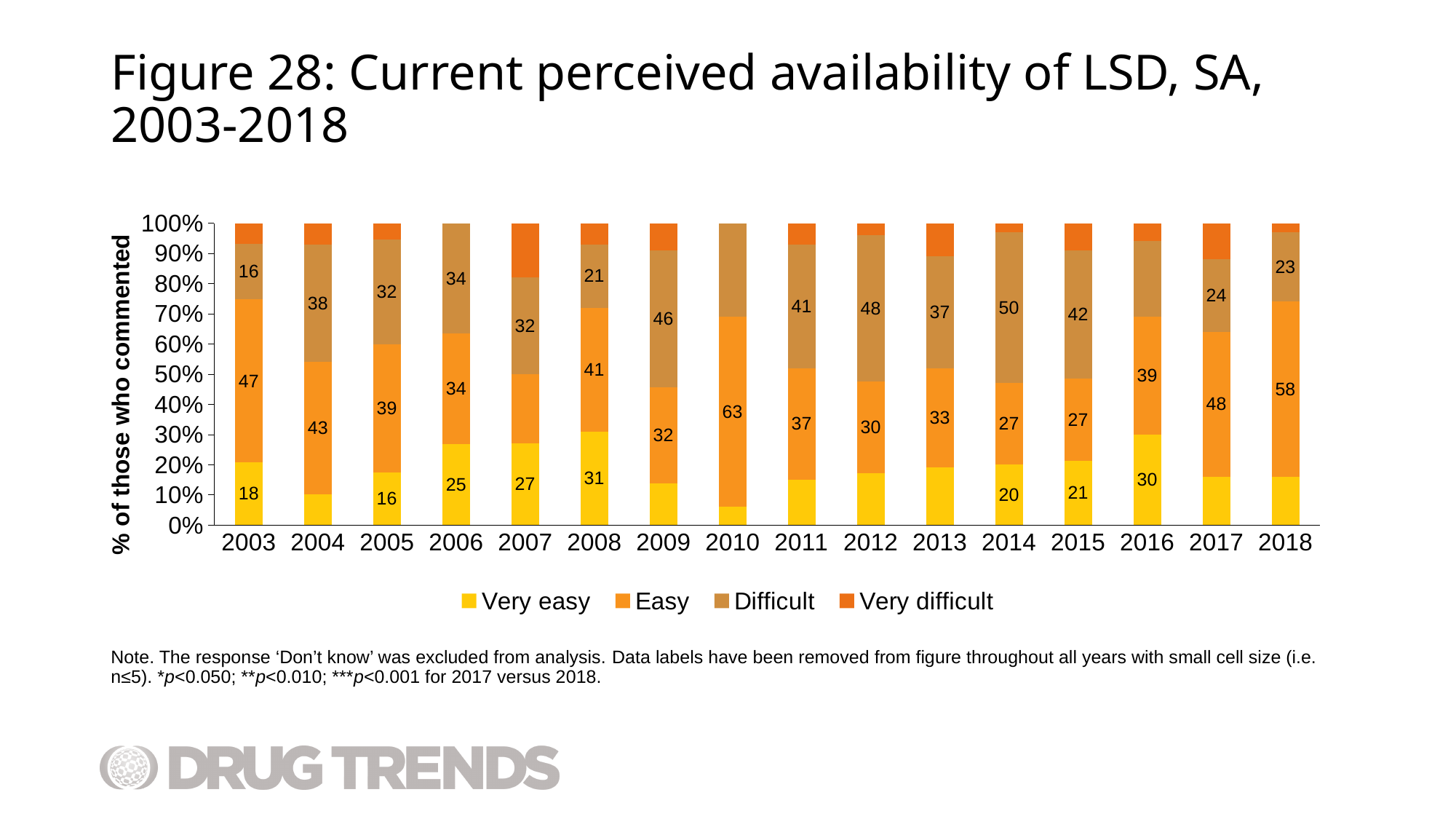
What kind of chart is shown on the slide? Stacked bar chart In which year is the labelled 'Easy' value the highest? 2010 What is the difference between the 'Easy' values for 2018 and 2017? 10 Which legend entry is shown in yellow? Very easy What is the 'Very easy' value for 2008? 31 How many series does the legend list? 4 In which year is the labelled 'Difficult' value the lowest? 2003 Is the 'Very easy' value for 2010 greater or less than 10%? less How many years are shown on the x axis? 16 Which is larger in 2009: the 'Easy' value or the 'Difficult' value? Difficult What is the 'Difficult' value for 2014? 50 What percentage of respondents rated LSD as 'Easy' to obtain in 2018? 58